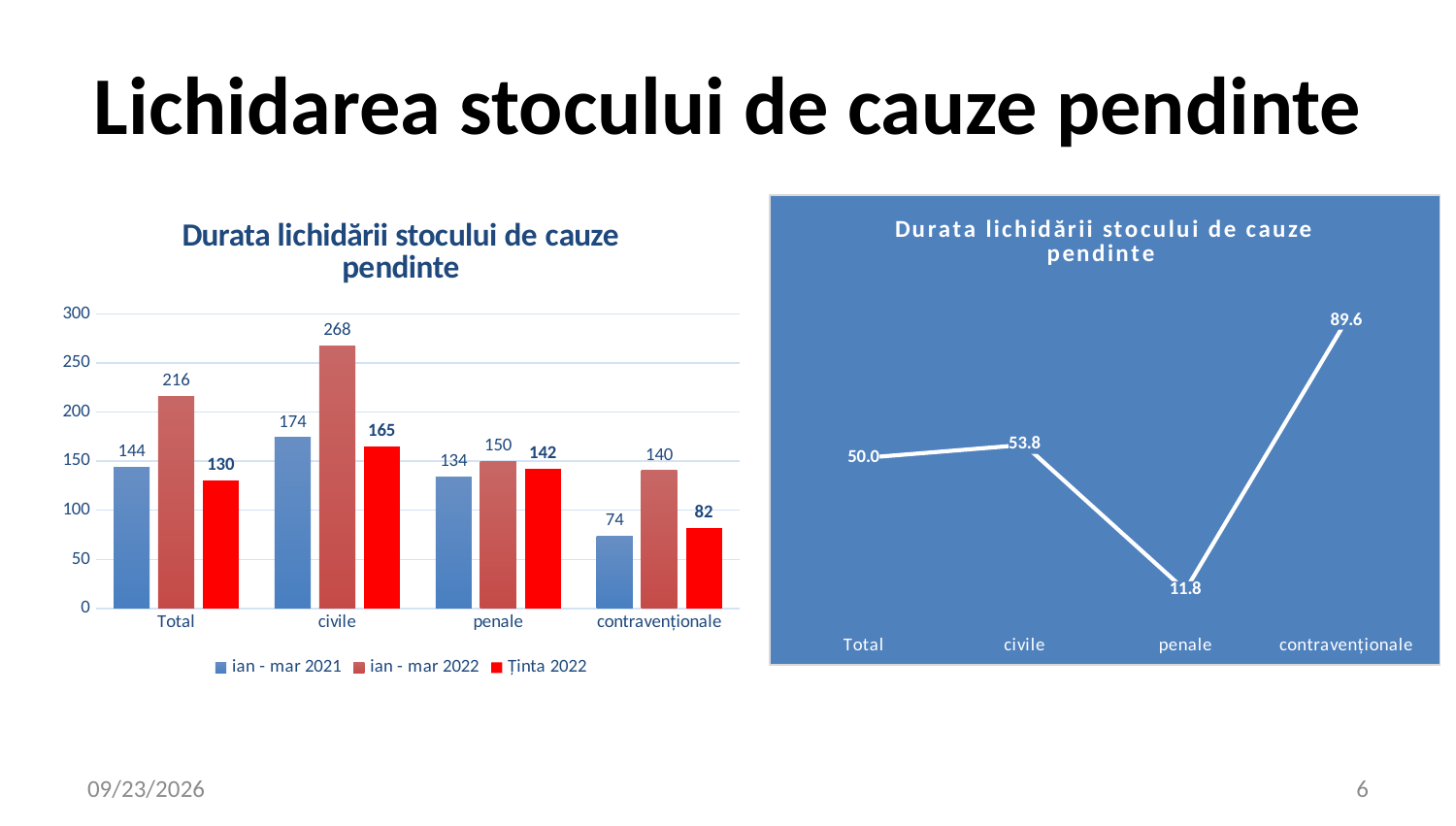
In the line chart on the right, what is the value for penale? 11.8 In the line chart on the right, what is the difference between the values for contravenționale and Total? 39.6 In the bar chart on the left, what is the difference between the ian - mar 2022 and ian - mar 2021 values for Total? 72 In the bar chart on the left, what is the Ținta 2022 value for contravenționale? 82 In the line chart on the right, which category has the highest value? contravenționale What kind of chart is shown on the right side of the slide? line chart How many series does the legend of the bar chart on the left list? 3 In the bar chart on the left, which category has the highest ian - mar 2022 value? civile In the bar chart on the left, which is larger for penale: the ian - mar 2022 value or the Ținta 2022 value? ian - mar 2022 In the bar chart on the left, what is the ian - mar 2021 value for penale? 134 In the bar chart on the left, what is the value for civile in the ian - mar 2022 series? 268 In the bar chart on the left, which category has the lowest ian - mar 2021 value? contravenționale